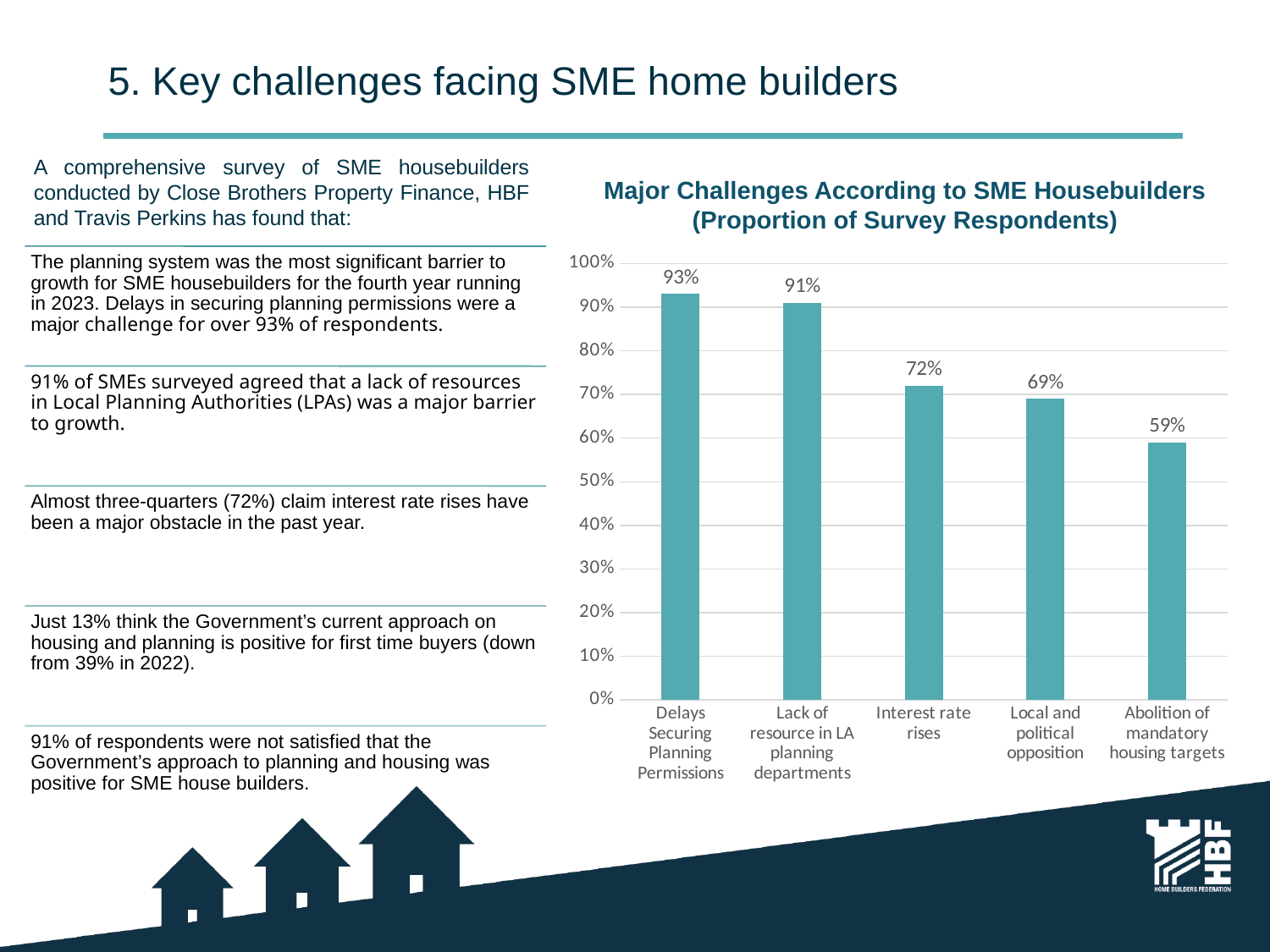
Which challenge has the lowest proportion of respondents? Abolition of mandatory housing targets What proportion of survey respondents cited Delays Securing Planning Permissions as a major challenge? 93% Which is larger: the value for Local and political opposition or the value for Abolition of mandatory housing targets? Local and political opposition What is the difference between the values for Interest rate rises and Local and political opposition? 3% How many challenge categories are shown in the chart? 5 What is the value for Abolition of mandatory housing targets? 59% What is the value for Interest rate rises? 72% What is the value for Lack of resource in LA planning departments? 91% What is the difference between the values for Delays Securing Planning Permissions and Abolition of mandatory housing targets? 34% What type of chart is shown on the slide? Bar chart Is the value for Interest rate rises greater or less than 80%? less Which challenge has the highest proportion of respondents? Delays Securing Planning Permissions